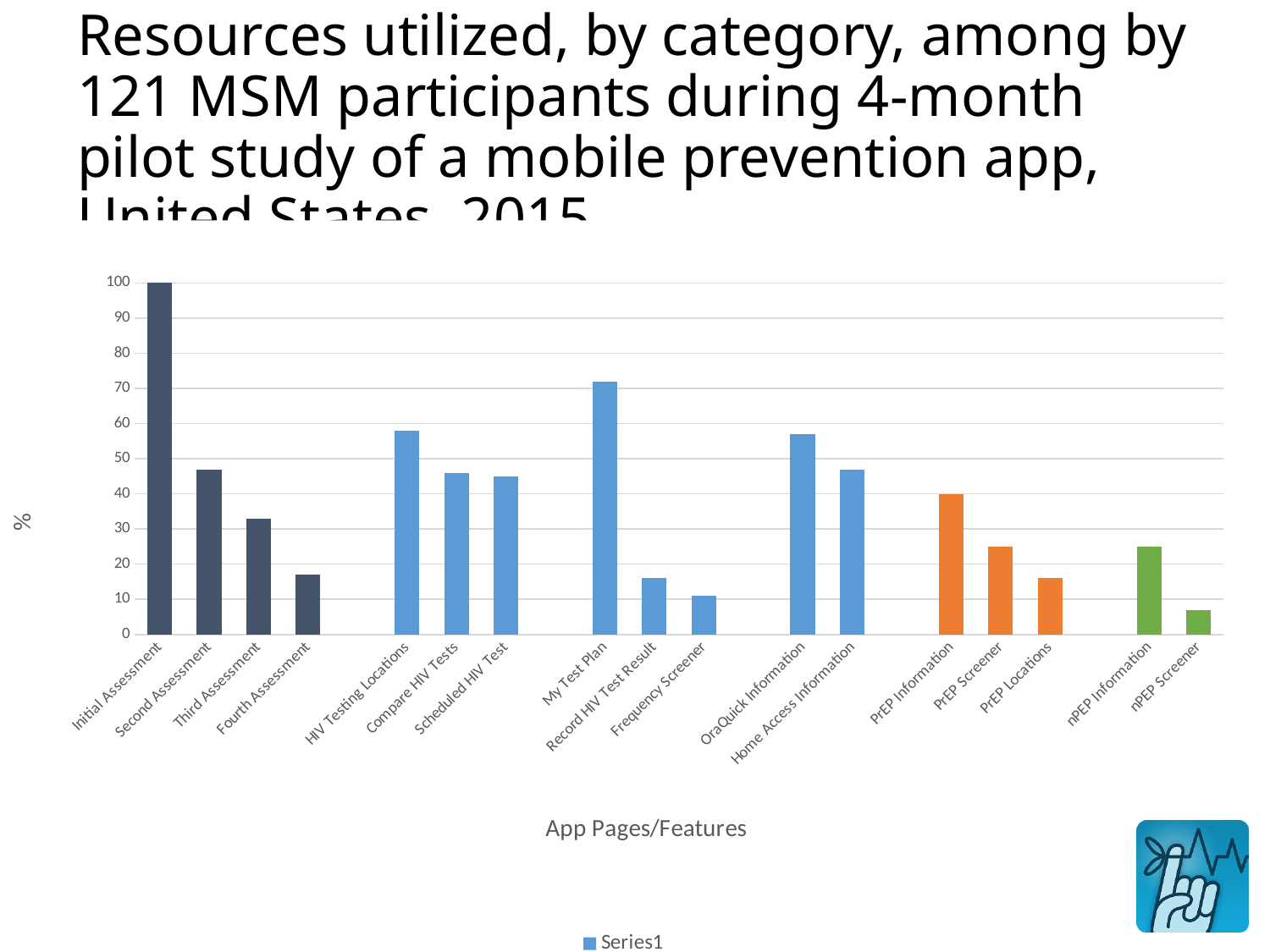
Which is larger, the value for My Test Plan or the value for OraQuick Information? My Test Plan Which app page/feature has the highest value? Initial Assessment Do the values rise or fall from Initial Assessment to Fourth Assessment? fall Is the value for My Test Plan greater or less than 60? greater How many app pages/features are plotted on the x axis? 17 What is the value for Initial Assessment? 100 How many series does the legend list? 1 Which app page/feature has the lowest value? nPEP Screener What is the title of the x axis? App Pages/Features Is the value for Third Assessment greater or less than 40? less What type of chart is shown on the slide? bar chart Is the value for Frequency Screener greater or less than 20? less